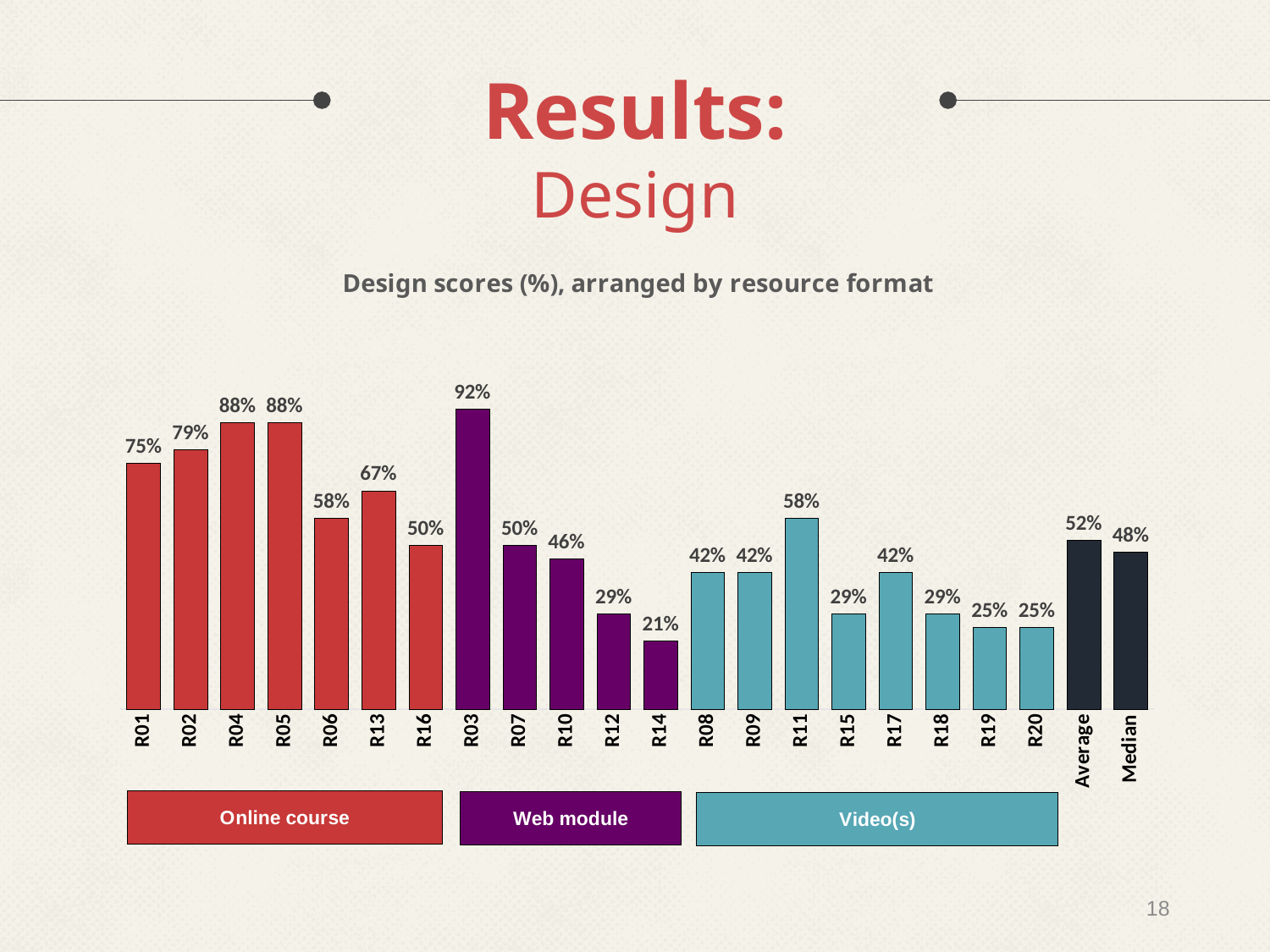
What is the difference between the design scores of R03 and R14? 71% What is the Median design score shown on the chart? 48% Which resource has the lowest design score? R14 What is the Average design score shown on the chart? 52% What type of chart is shown on the slide? Bar chart What is the design score for R14? 21% How many bars are labelled with resource codes (R01 to R20) on the chart? 20 Which has a higher design score, R11 or R17? R11 What is the difference between the Average and Median design scores? 4% What are the three resource format groups labelled below the chart? Online course, Web module, Video(s) Which resource has the highest design score? R03 What is the design score for R03? 92%